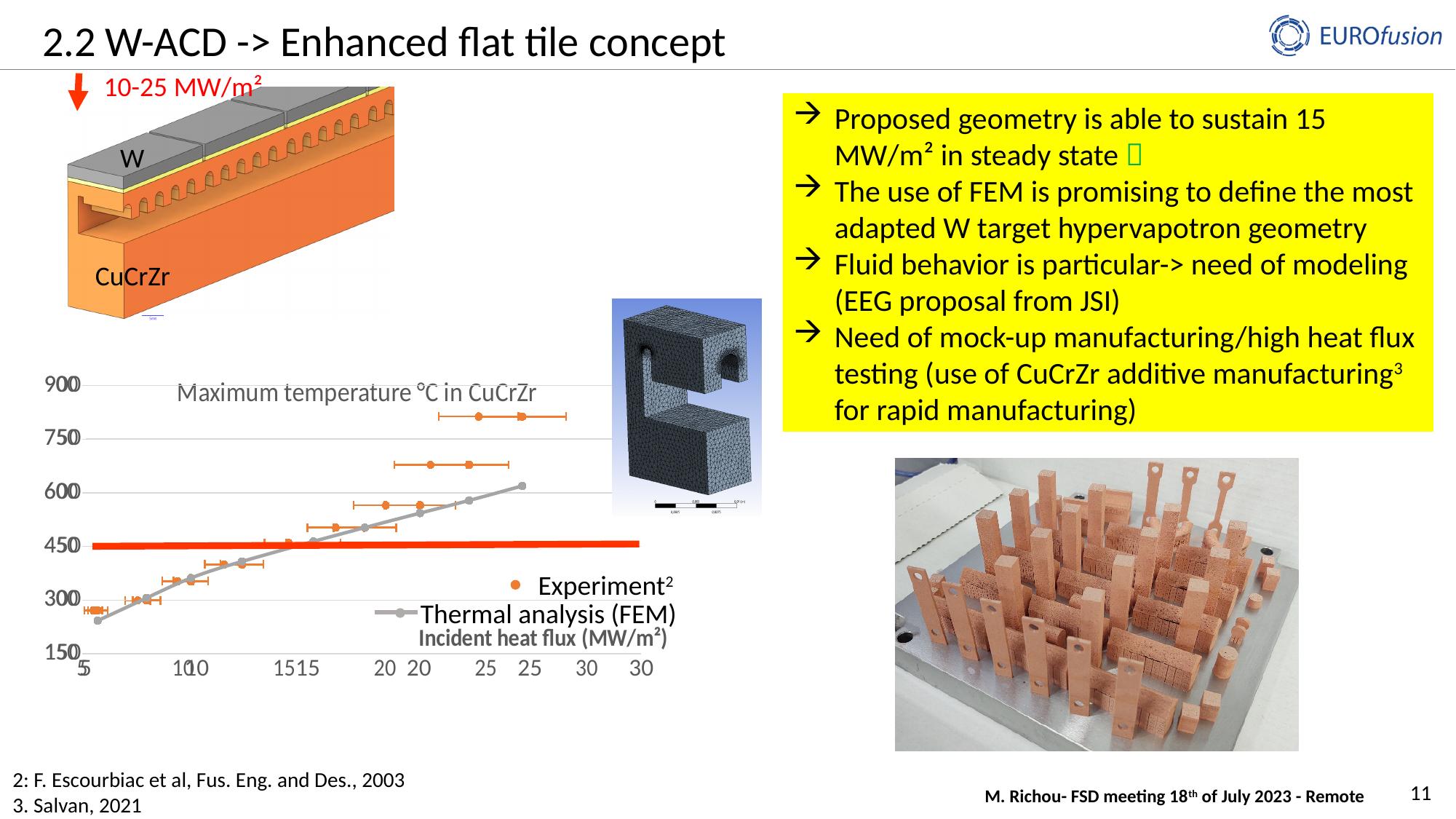
At about 25 MW/m², which series shows the higher temperature, Experiment or Thermal analysis (FEM)? Experiment What are the two series named in the chart legend? Experiment and Thermal analysis (FEM) Is the Thermal analysis (FEM) value at about 10 MW/m² greater or less than 300? greater How many series does the chart legend list? 2 Which series reaches the highest temperature on the chart? Experiment Is the Thermal analysis (FEM) value at 5 MW/m² greater or less than 300? less What kind of chart is shown on the slide? line chart with markers (scatter) What is the highest value shown on the y axis of the chart? 900 Is the Experiment value at about 25 MW/m² greater or less than 750? greater What is the title of the chart? Maximum temperature °C in CuCrZr Does the maximum temperature rise or fall as the incident heat flux increases? rise